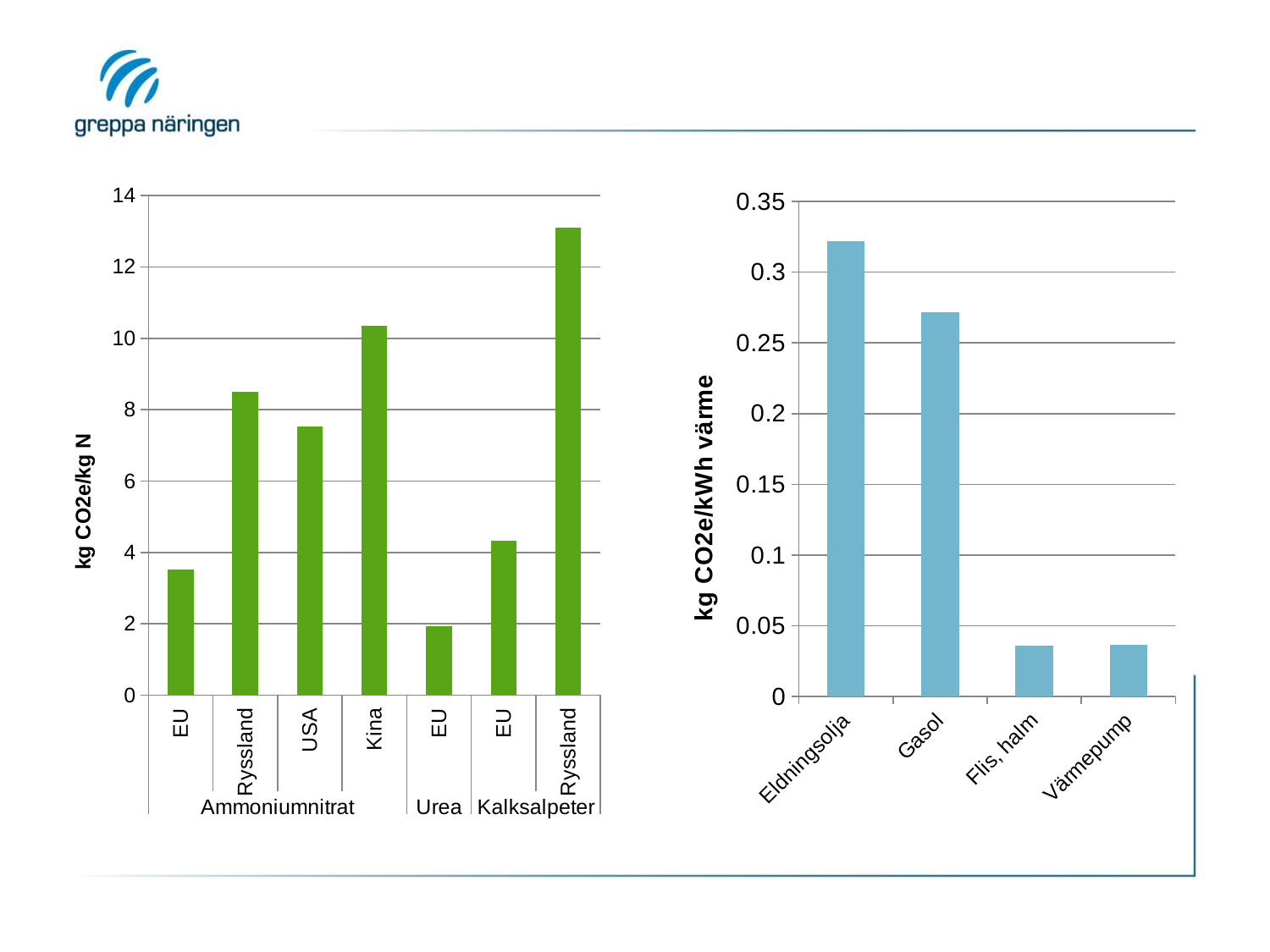
What is the y-axis label of the right chart? kg CO2e/kWh värme In the left chart, is the value for Ammoniumnitrat Ryssland greater or less than 8? greater In the left chart, is the value for Ammoniumnitrat EU greater or less than 4? less In the right chart, is the value for Gasol greater or less than 0.25? greater In the left chart, which is larger among the Ammoniumnitrat bars: USA or Kina? Kina In the left chart, which bar is the lowest? Urea EU In the left chart, which bar is the highest? Kalksalpeter Ryssland What kind of chart is the left chart? bar chart What is the y-axis label of the left chart? kg CO2e/kg N How many categories does the right chart show? 4 In the right chart, which category has the highest value? Eldningsolja How many bars does the left chart show? 7